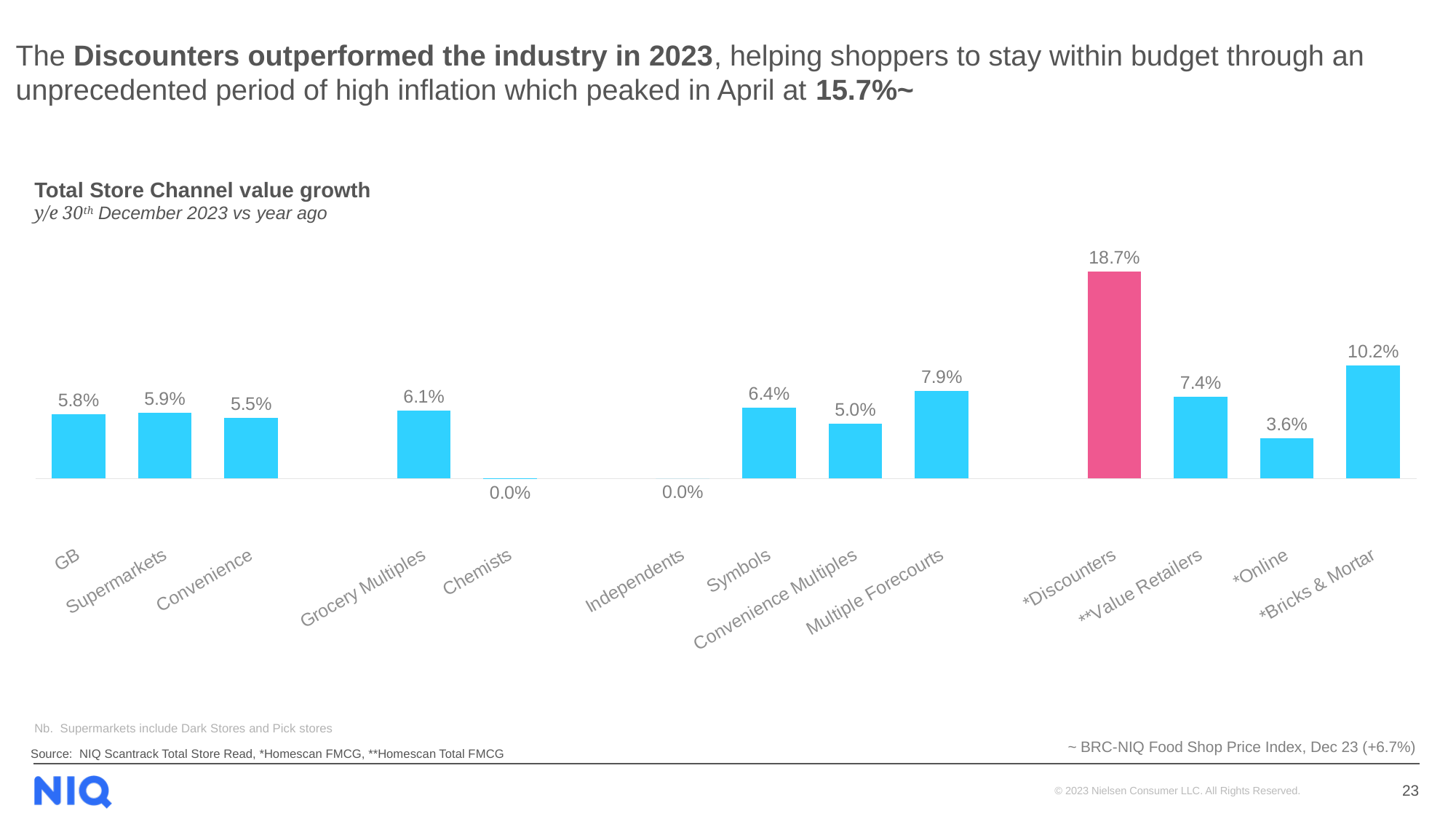
What is the value growth for GB? 5.8% What is the value growth for Online? 3.6% Which has higher value growth, Online or Convenience Multiples? Convenience Multiples What is the difference in value growth between Supermarkets and Convenience? 0.4% Which bar is shown in a different colour (pink) from the others? Discounters Which channel has the highest value growth? Discounters Which has higher value growth, Value Retailers or Multiple Forecourts? Multiple Forecourts What is the value growth for Bricks & Mortar? 10.2% What is the value growth for Multiple Forecourts? 7.9% What is the difference in value growth between Discounters and Bricks & Mortar? 8.5% What kind of chart is shown on the slide? Bar chart What is the value growth for Discounters? 18.7%